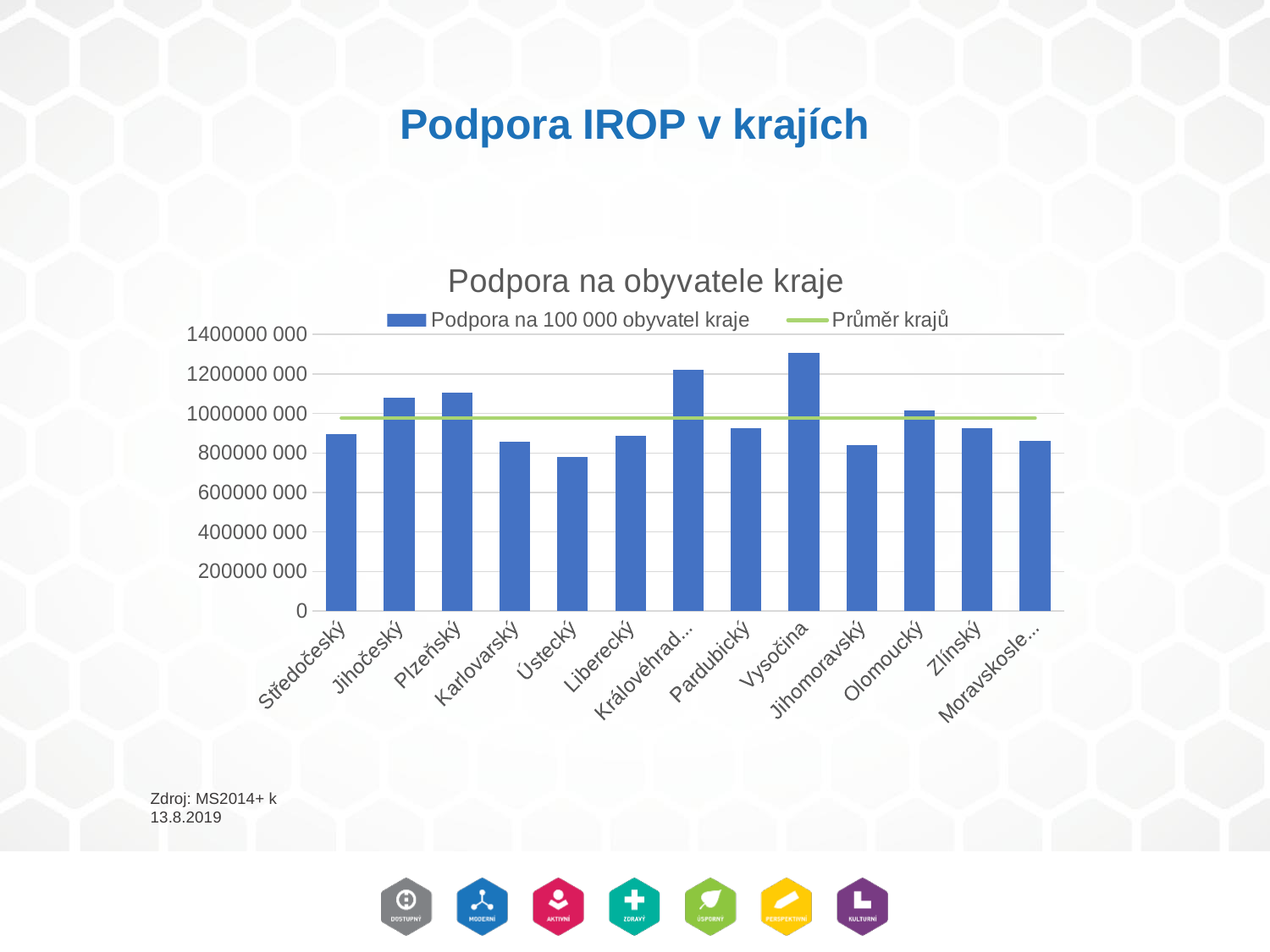
Which has a larger value, Olomoucký or Jihomoravský? Olomoucký How many regions (categories) are shown on the x axis? 13 What kind of chart is shown on the slide? combination bar and line chart Which region has the highest value for Podpora na 100 000 obyvatel kraje? Vysočina What is the title of the chart? Podpora na obyvatele kraje Is the value for Karlovarský greater or less than 1000000 000? less Is the value for Jihočeský greater or less than 1000000 000? greater Which region has the lowest value for Podpora na 100 000 obyvatel kraje? Ústecký What is the name of the series drawn as a green line? Průměr krajů How many series does the legend list? 2 Is the value for Vysočina greater or less than 1200000 000? greater